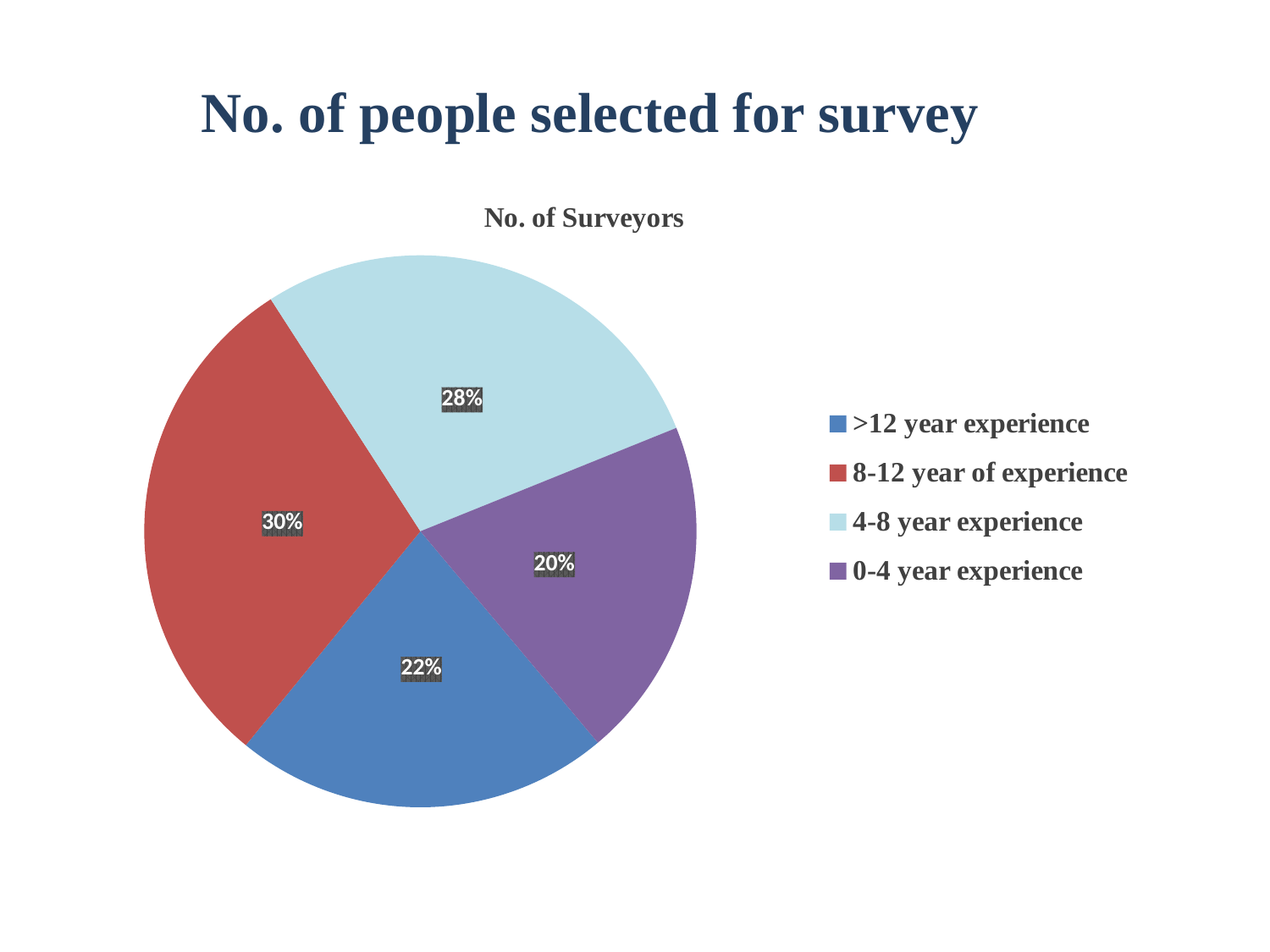
Which is larger, the share for >12 year experience or the share for 4-8 year experience? 4-8 year experience What is the difference in percentage points between the 8-12 year of experience slice and the 0-4 year experience slice? 10 What is the title of the chart? No. of Surveyors What share of the pie does the 8-12 year of experience slice represent? 30% What type of chart is shown on the slide? pie chart Which category has the smallest share of the pie? 0-4 year experience What share of the pie does the >12 year experience slice represent? 22% What share of the pie does the 4-8 year experience slice represent? 28% How many categories does the pie chart show? 4 Which category has the largest share of the pie? 8-12 year of experience What colour is the slice for 0-4 year experience? purple